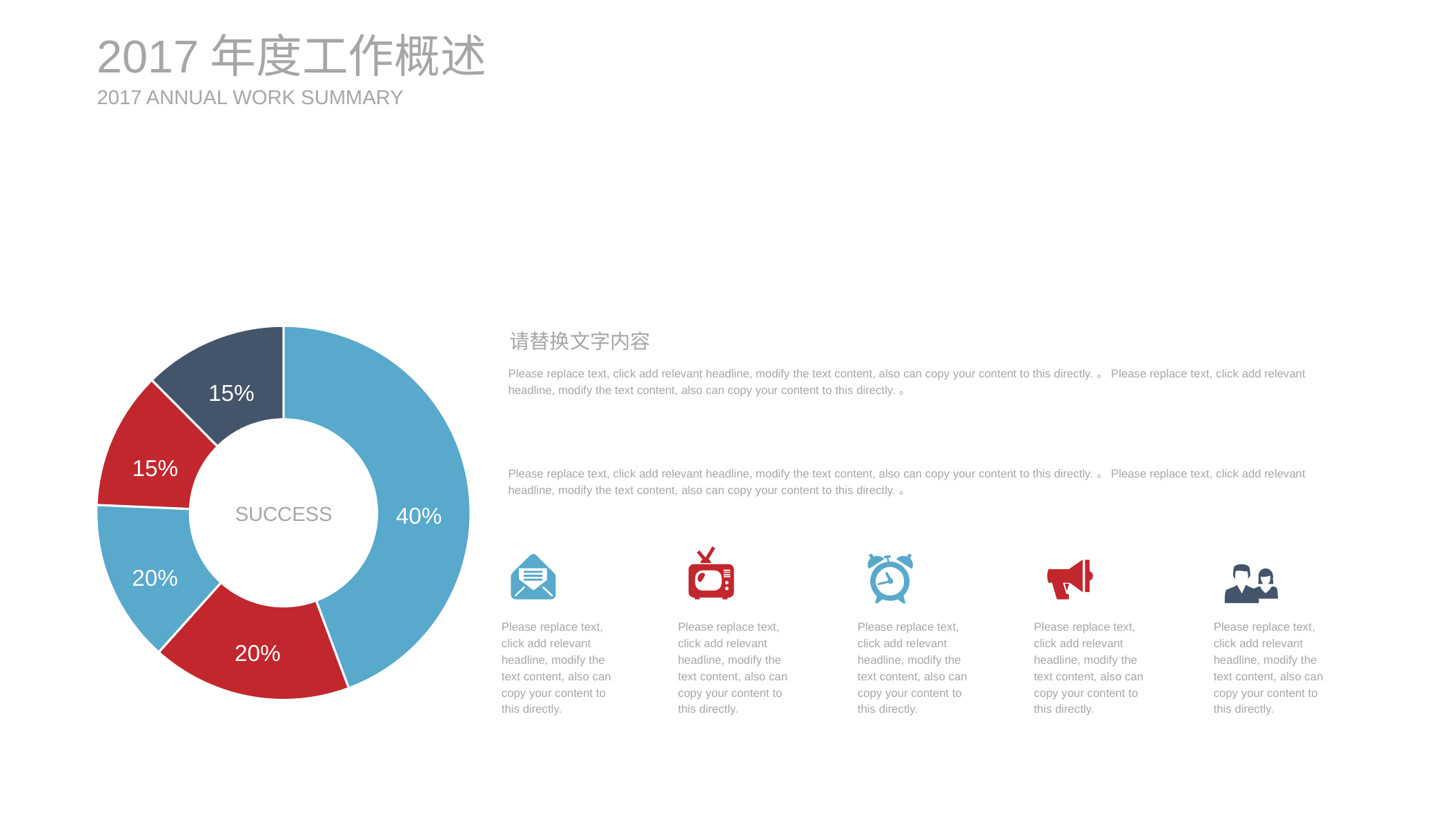
What is the difference between the 40% slice and the dark navy 15% slice? 25 percentage points What is the smallest value labeled on the doughnut chart? 15% How many slices does the doughnut chart have? 5 Which is larger, the dark navy slice at the top left or the red slice at the bottom of the doughnut chart? The red slice at the bottom (20%) What word is written in the center of the doughnut chart? SUCCESS What is the largest value labeled on the doughnut chart? 40% What value is labeled on the large light-blue slice on the right side of the doughnut chart? 40% What value is labeled on the red slice at the bottom of the doughnut chart? 20% What kind of chart is shown on the left of the slide? Doughnut chart How many slices of the doughnut chart are labeled 15%? 2 What value is labeled on the dark navy slice at the top left of the doughnut chart? 15% What value is labeled on the light-blue slice on the left side of the doughnut chart? 20%